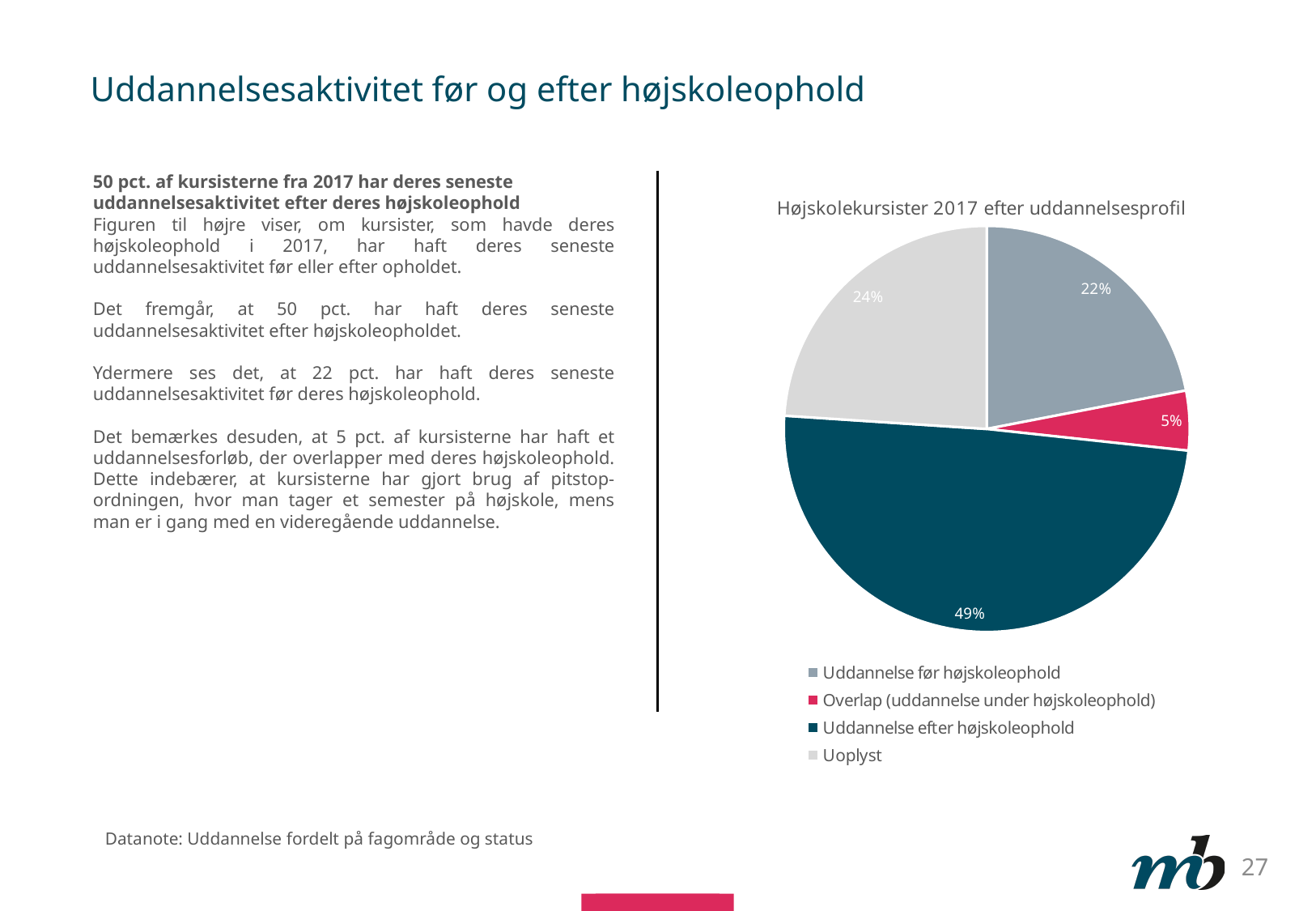
Which category has the largest slice of the pie? Uddannelse efter højskoleophold Which is larger: the slice for 'Uoplyst' or the slice for 'Uddannelse før højskoleophold'? Uoplyst What share of the pie is labelled 'Uddannelse efter højskoleophold'? 49% What colour is the slice for 'Overlap (uddannelse under højskoleophold)'? Red What share of the pie is labelled 'Overlap (uddannelse under højskoleophold)'? 5% What share of the pie is labelled 'Uoplyst'? 24% What is the difference in percentage points between 'Uddannelse efter højskoleophold' and 'Uddannelse før højskoleophold'? 27 percentage points What is the title of the chart? Højskolekursister 2017 efter uddannelsesprofil Which category has the smallest slice of the pie? Overlap (uddannelse under højskoleophold) What share of the pie is labelled 'Uddannelse før højskoleophold'? 22% What type of chart is shown on the slide? Pie chart How many categories does the legend list? 4